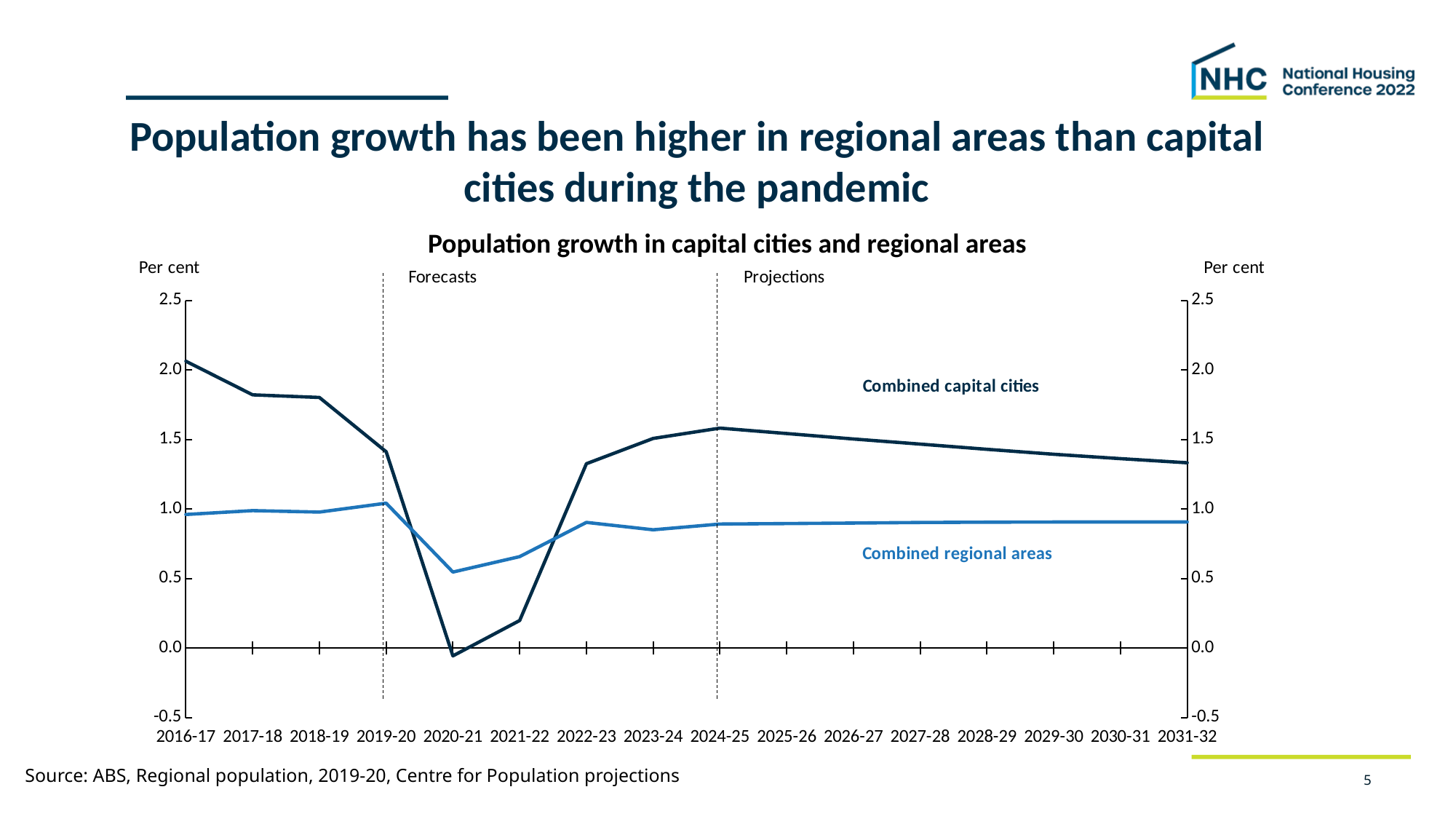
What is the title of the chart? Population growth in capital cities and regional areas What kind of chart is shown on the slide? Line chart In which year does the Combined capital cities line reach its lowest value? 2020-21 Is the value for Combined capital cities in 2020-21 greater or less than 0.5? less In 2031-32, which series has the higher value, Combined capital cities or Combined regional areas? Combined capital cities In 2020-21, which series has the higher value, Combined capital cities or Combined regional areas? Combined regional areas How many series are plotted on the chart? 2 How many financial years are shown on the x axis? 16 Does the Combined capital cities line rise or fall from 2024-25 to 2031-32? Fall Is the value for Combined capital cities in 2031-32 greater or less than 1.5? less In which year does the Combined regional areas line reach its lowest value? 2020-21 In which year does the Combined capital cities line reach its highest value? 2016-17